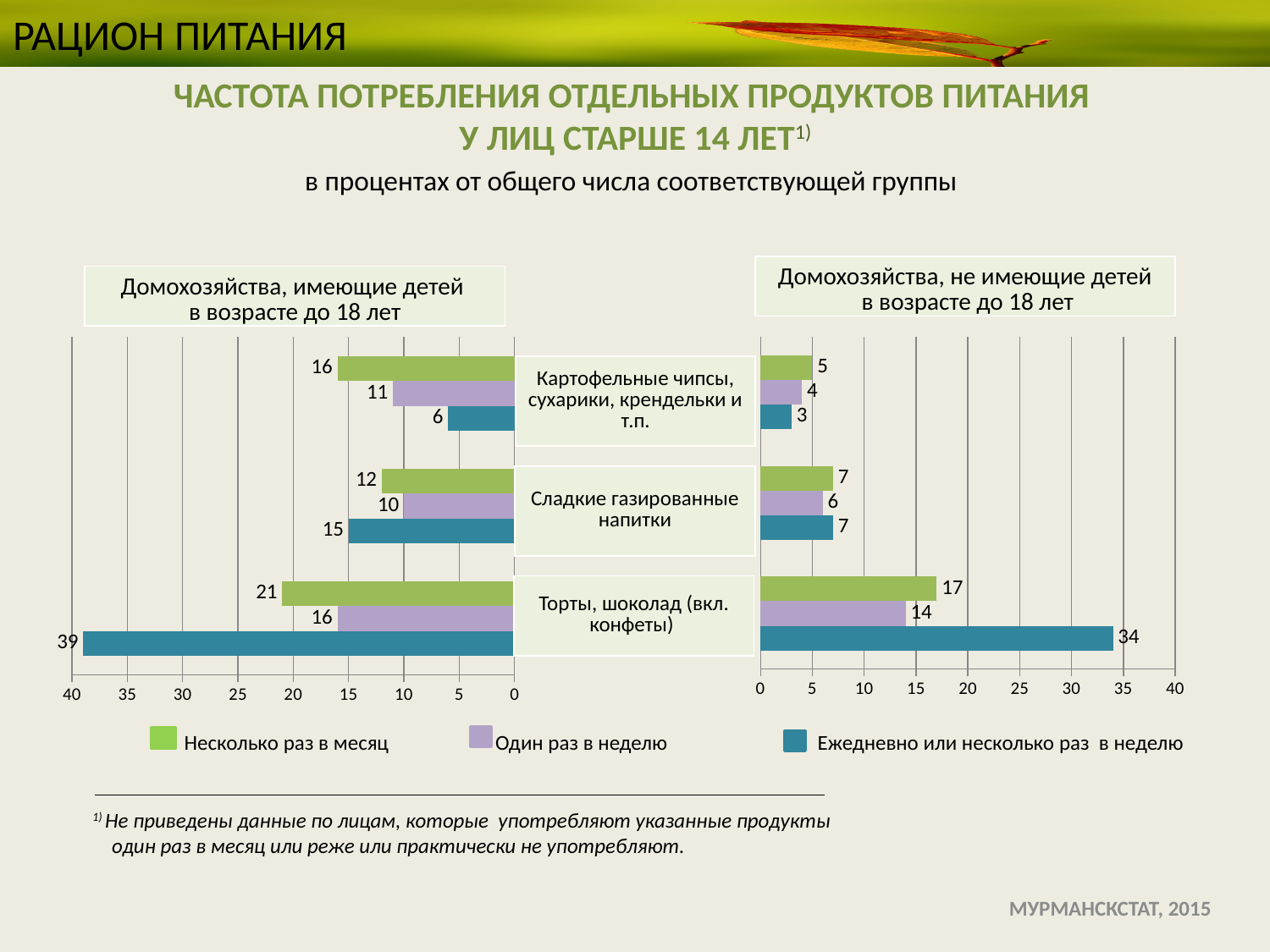
On the left chart (Домохозяйства, имеющие детей в возрасте до 18 лет), what is the value for 'Один раз в неделю' for 'Сладкие газированные напитки'? 10 What is the difference between the 'Ежедневно или несколько раз в неделю' value for 'Торты, шоколад (вкл. конфеты)' on the left chart and the same value on the right chart? 5 On the right chart (Домохозяйства, не имеющие детей в возрасте до 18 лет), which category has the highest value for 'Ежедневно или несколько раз в неделю'? Торты, шоколад (вкл. конфеты) How many series does the legend list? 3 On the right chart (Домохозяйства, не имеющие детей в возрасте до 18 лет), what is the value for 'Несколько раз в месяц' for 'Картофельные чипсы, сухарики, крендельки и т.п.'? 5 How many product categories are shown on each chart? 3 On the left chart (Домохозяйства, имеющие детей в возрасте до 18 лет), which is larger for 'Сладкие газированные напитки': 'Несколько раз в месяц' or 'Ежедневно или несколько раз в неделю'? Ежедневно или несколько раз в неделю What kind of chart is used on the slide? Bar chart On the right chart (Домохозяйства, не имеющие детей в возрасте до 18 лет), what is the difference between 'Несколько раз в месяц' and 'Один раз в неделю' for 'Торты, шоколад (вкл. конфеты)'? 3 On the right chart (Домохозяйства, не имеющие детей в возрасте до 18 лет), which category has the lowest value for 'Ежедневно или несколько раз в неделю'? Картофельные чипсы, сухарики, крендельки и т.п. On the left chart (Домохозяйства, имеющие детей в возрасте до 18 лет), is the 'Ежедневно или несколько раз в неделю' value for 'Торты, шоколад (вкл. конфеты)' greater or less than 35? greater On the left chart (Домохозяйства, имеющие детей в возрасте до 18 лет), what is the value for 'Ежедневно или несколько раз в неделю' for 'Торты, шоколад (вкл. конфеты)'? 39